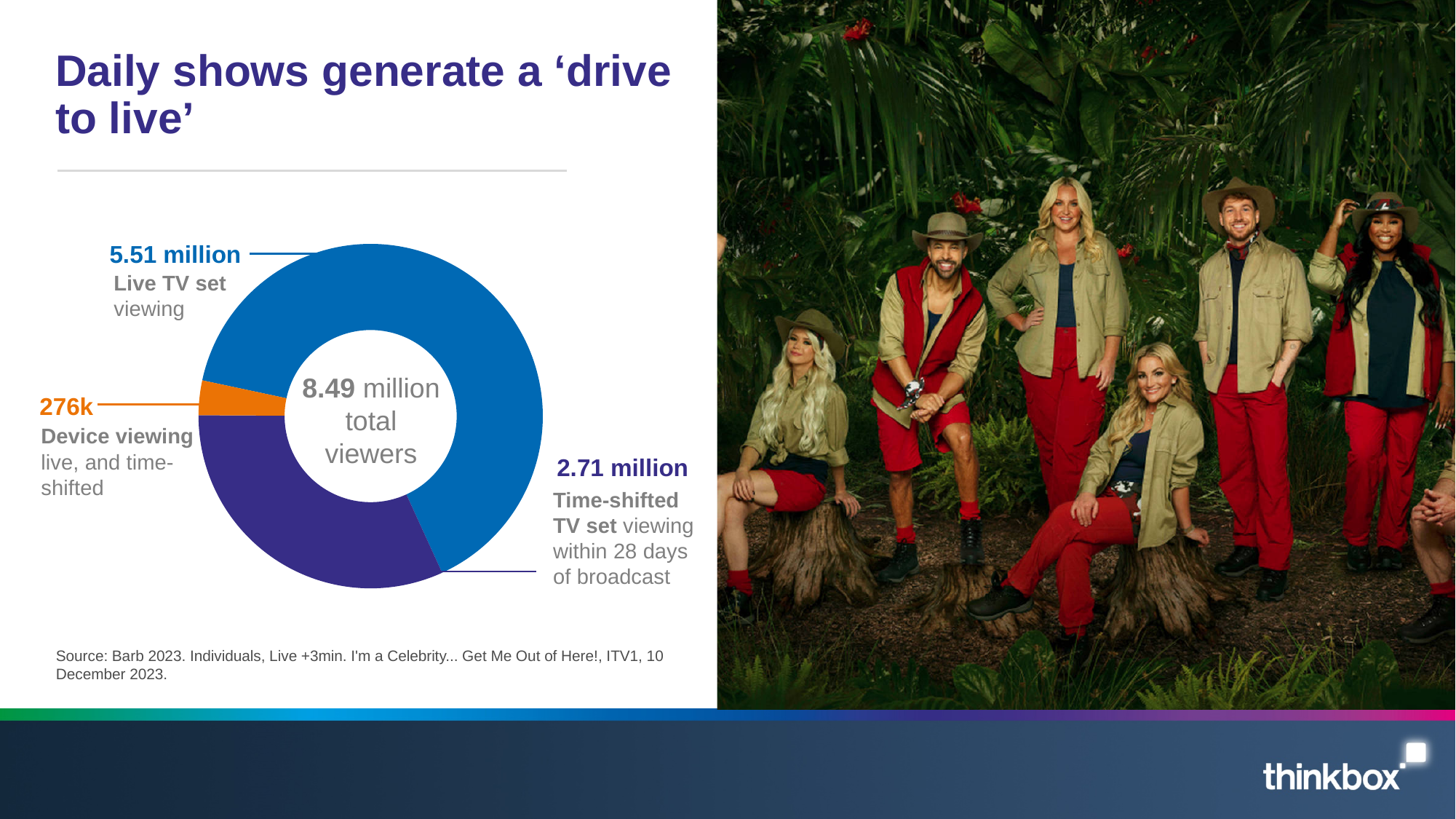
Which is larger: Time-shifted TV set viewing or Device viewing? Time-shifted TV set viewing What is the value for Device viewing (live and time-shifted)? 276k Which viewing category has the smallest segment of the donut chart? Device viewing How many segments does the donut chart have? 3 What is the total number of viewers shown in the centre of the donut chart? 8.49 million What is the value for Live TV set viewing? 5.51 million What colour is the Device viewing segment of the donut chart? Orange What kind of chart is shown on the slide? Donut (pie) chart Which viewing category has the largest segment of the donut chart? Live TV set viewing What is the title of the slide containing the donut chart? Daily shows generate a ‘drive to live’ What is the difference between Live TV set viewing and Time-shifted TV set viewing? 2.80 million What is the value for Time-shifted TV set viewing within 28 days of broadcast? 2.71 million